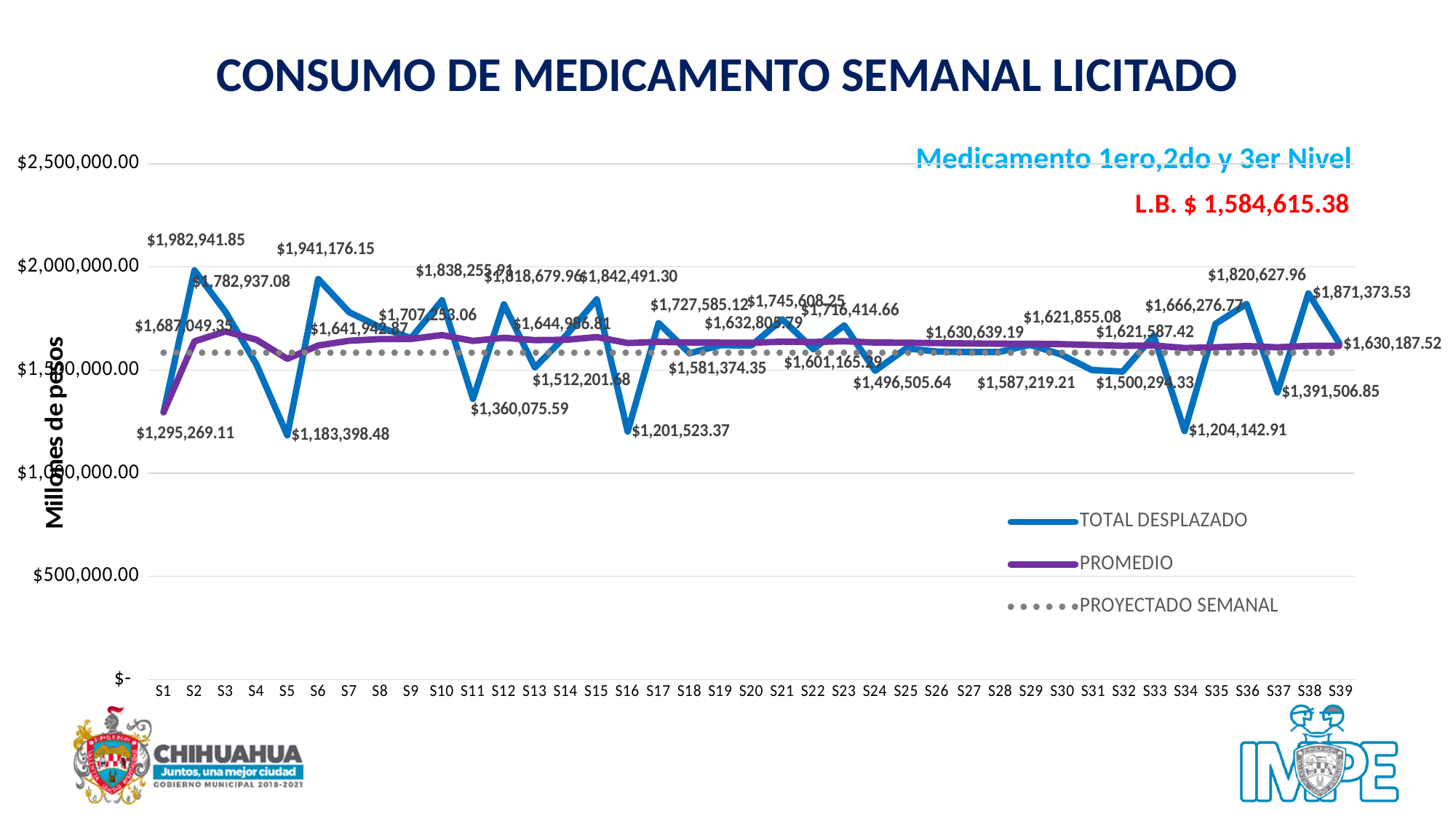
Is the TOTAL DESPLAZADO value for S5 greater or less than $1,500,000.00? less In which week is TOTAL DESPLAZADO lowest? S5 How many weeks (S1 to S39) are plotted on the x axis? 39 What is the title of the chart? CONSUMO DE MEDICAMENTO SEMANAL LICITADO What is the TOTAL DESPLAZADO value for S1? $1,295,269.11 What is the TOTAL DESPLAZADO value for S2? $1,982,941.85 In which week is TOTAL DESPLAZADO highest? S2 What is the TOTAL DESPLAZADO value for S39? $1,630,187.52 What is the L.B. value shown in red on the slide? $ 1,584,615.38 Which is larger for TOTAL DESPLAZADO, S2 or S6? S2 How many series does the legend list? 3 What type of chart is shown on the slide? Line chart